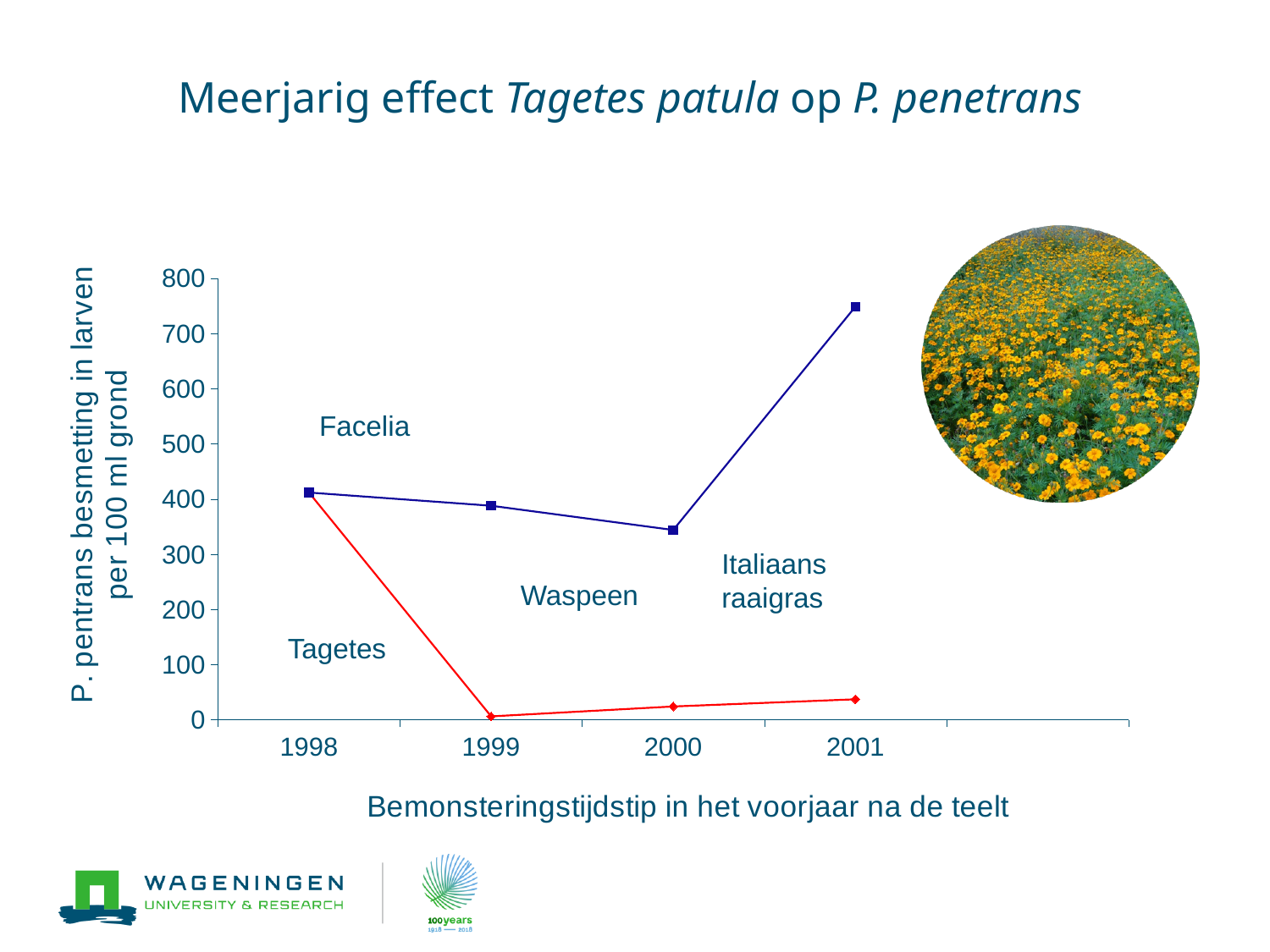
What is the label of the x axis of the chart? Bemonsteringstijdstip in het voorjaar na de teelt In which year does the red line reach its lowest value? 1999 How many years are shown on the x axis of the chart? 4 Is the value of the blue line in 2001 greater or less than 700? greater In which year does the blue line reach its highest value? 2001 Is the value of the red line in 2001 greater or less than 100? less Is the value of the blue line in 2000 greater or less than 300? greater How many lines are plotted in the chart? 2 What kind of chart is shown on the slide? line chart In 2000, which line has the larger value, the blue line or the red line? the blue line Does the blue line rise or fall from 2000 to 2001? rise Does the red line rise or fall from 1998 to 1999? fall